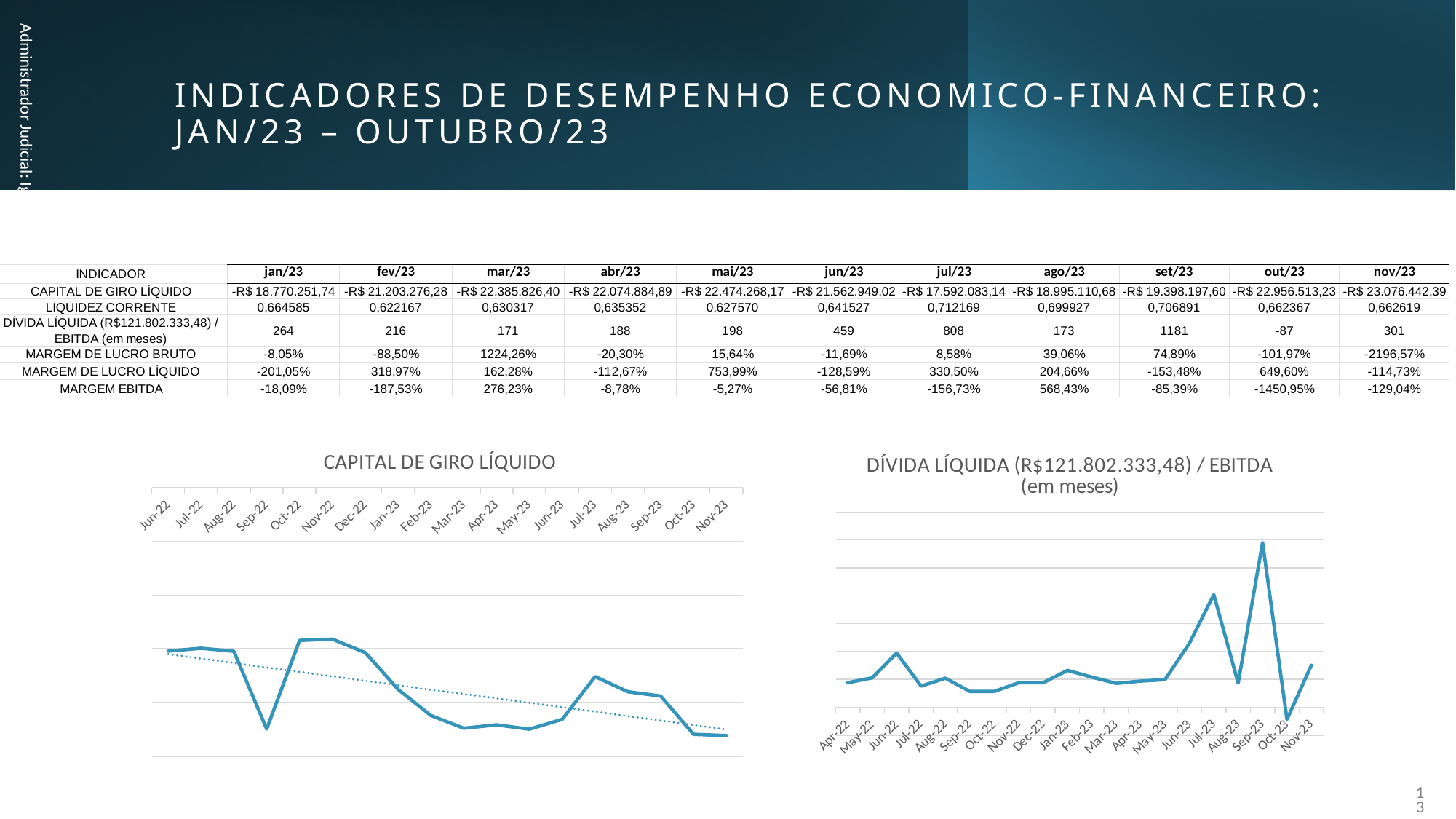
In the DÍVIDA LÍQUIDA / EBITDA chart, which month has the lowest point? Oct-23 How many months are plotted on the x axis of the DÍVIDA LÍQUIDA / EBITDA chart? 20 How many months are plotted on the x axis of the CAPITAL DE GIRO LÍQUIDO chart? 18 According to the table on the slide, what value does the Oct-23 point in the DÍVIDA LÍQUIDA / EBITDA chart correspond to? -87 According to the dotted trend line in the CAPITAL DE GIRO LÍQUIDO chart, do values rise or fall from Jun-22 to Nov-23? fall What kind of chart is the CAPITAL DE GIRO LÍQUIDO chart? line chart What kind of chart is the DÍVIDA LÍQUIDA / EBITDA (em meses) chart? line chart According to the table on the slide, what value does the Sep-23 peak in the DÍVIDA LÍQUIDA / EBITDA chart correspond to? 1181 In the DÍVIDA LÍQUIDA / EBITDA chart, which month has the highest point? Sep-23 Which month does the x axis of the DÍVIDA LÍQUIDA / EBITDA chart start with? Apr-22 In the DÍVIDA LÍQUIDA / EBITDA chart, which is higher, Jun-22 or Jul-22? Jun-22 In the DÍVIDA LÍQUIDA / EBITDA chart, which is higher, Jul-23 or Sep-23? Sep-23